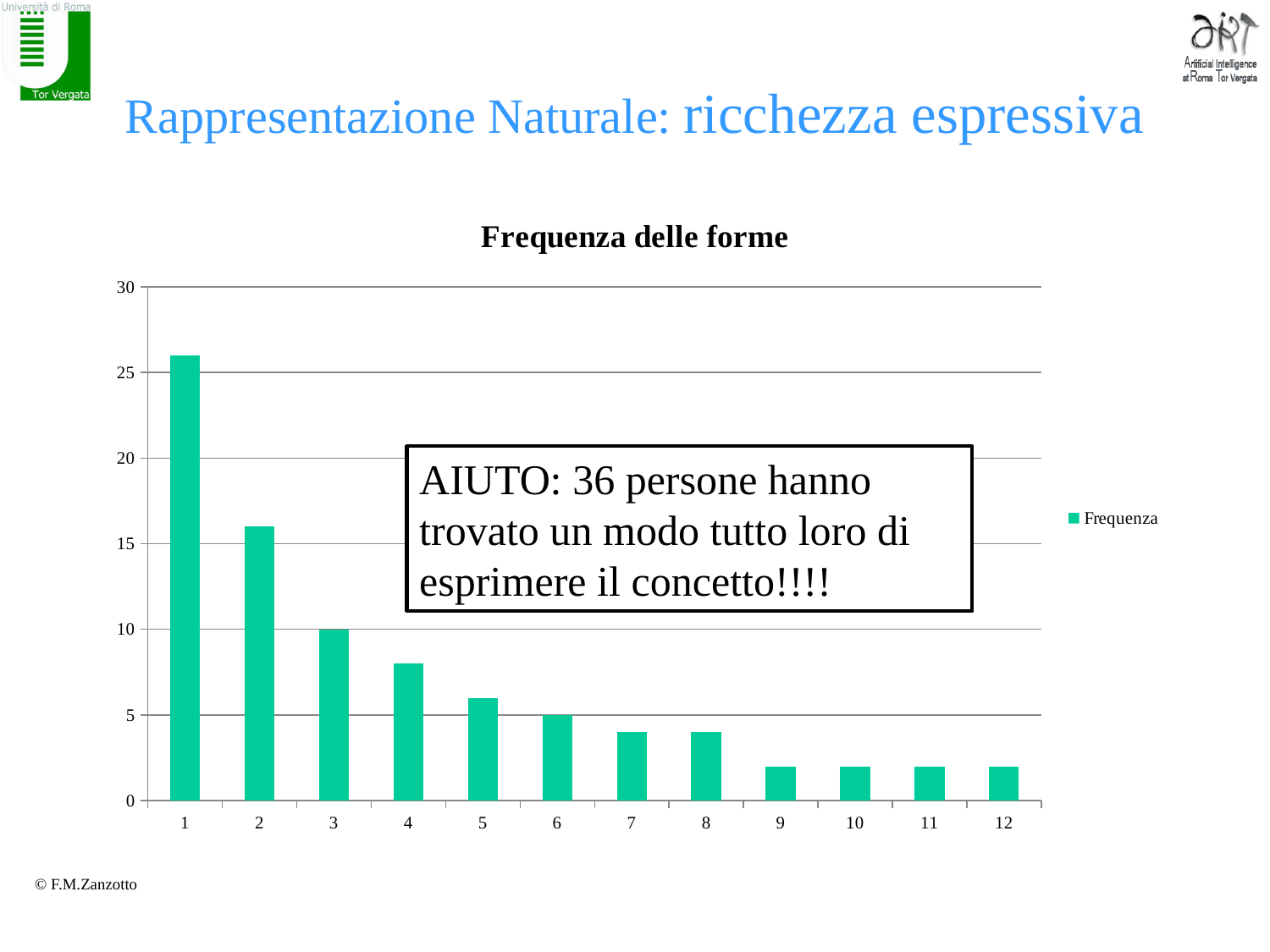
Is the value for category 4 greater or less than 10? less Is the value for category 9 greater or less than 5? less Which category has the highest value? 1 How many series does the legend list? 1 What is the title of the chart? Frequenza delle forme Is the value for category 1 greater or less than 25? greater Which is larger, the value for category 1 or the value for category 2? 1 Do the values rise or fall as you move from category 1 to category 12? fall How many categories are plotted on the x axis? 12 What is the name of the series shown in the legend? Frequenza What kind of chart is shown on the slide? bar chart